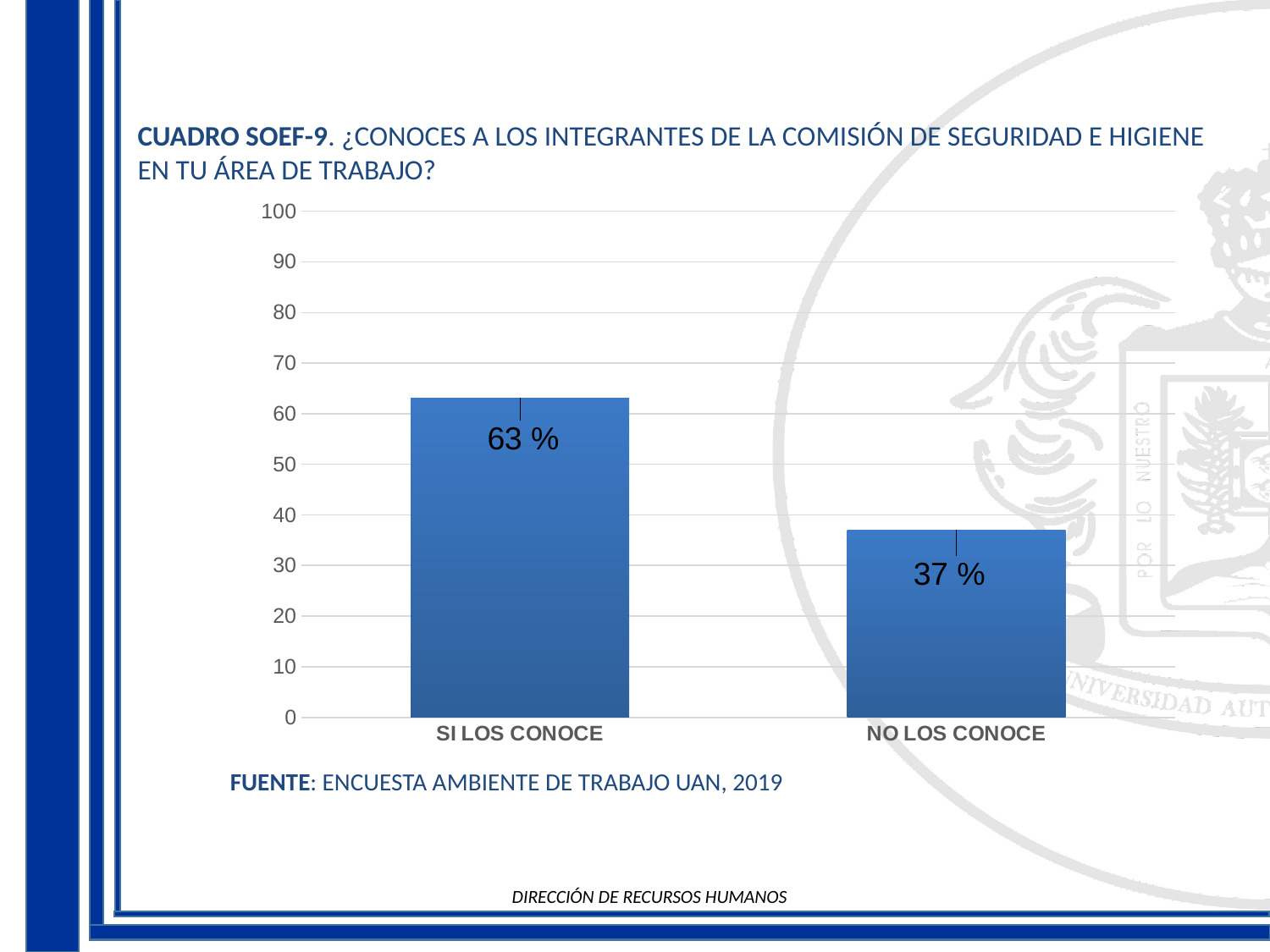
Is the value for NO LOS CONOCE greater or less than 40? less What is the value for SI LOS CONOCE? 63 % What is the value for NO LOS CONOCE? 37 % Which category has the lowest value? NO LOS CONOCE What is the total of the two values shown on the chart? 100 % Which category has the highest value? SI LOS CONOCE How many categories are shown on the chart? 2 Which is larger, the value for SI LOS CONOCE or NO LOS CONOCE? SI LOS CONOCE What kind of chart is shown on the slide? bar chart Is the value for SI LOS CONOCE greater or less than 60? greater What is the source cited below the chart? ENCUESTA AMBIENTE DE TRABAJO UAN, 2019 What is the difference between the values for SI LOS CONOCE and NO LOS CONOCE? 26 %